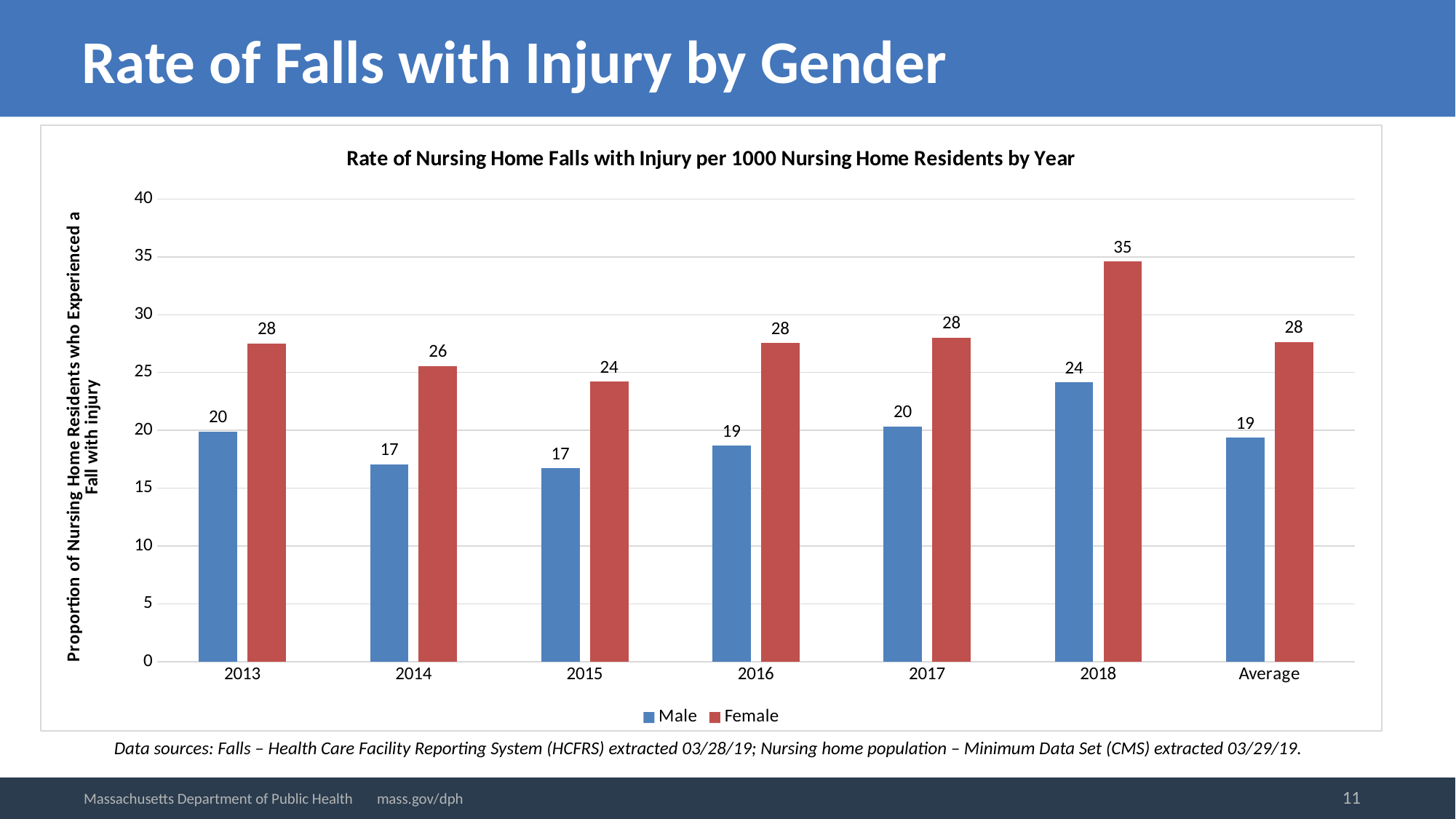
What kind of chart is shown on the slide? Bar chart How many categories are shown on the x axis? 7 What is the Male value for the Average category? 19 In which year is the Female value highest? 2018 What is the Male value for 2014? 17 What is the difference between the Female and Male values in 2013? 8 Which is larger in 2015, the Male value or the Female value? Female How many series does the legend list? 2 What is the Female value for 2018? 35 In which year is the Male value highest? 2018 What is the difference between the Female and Male values in 2018? 11 Is the Female value for 2018 greater or less than 30? greater